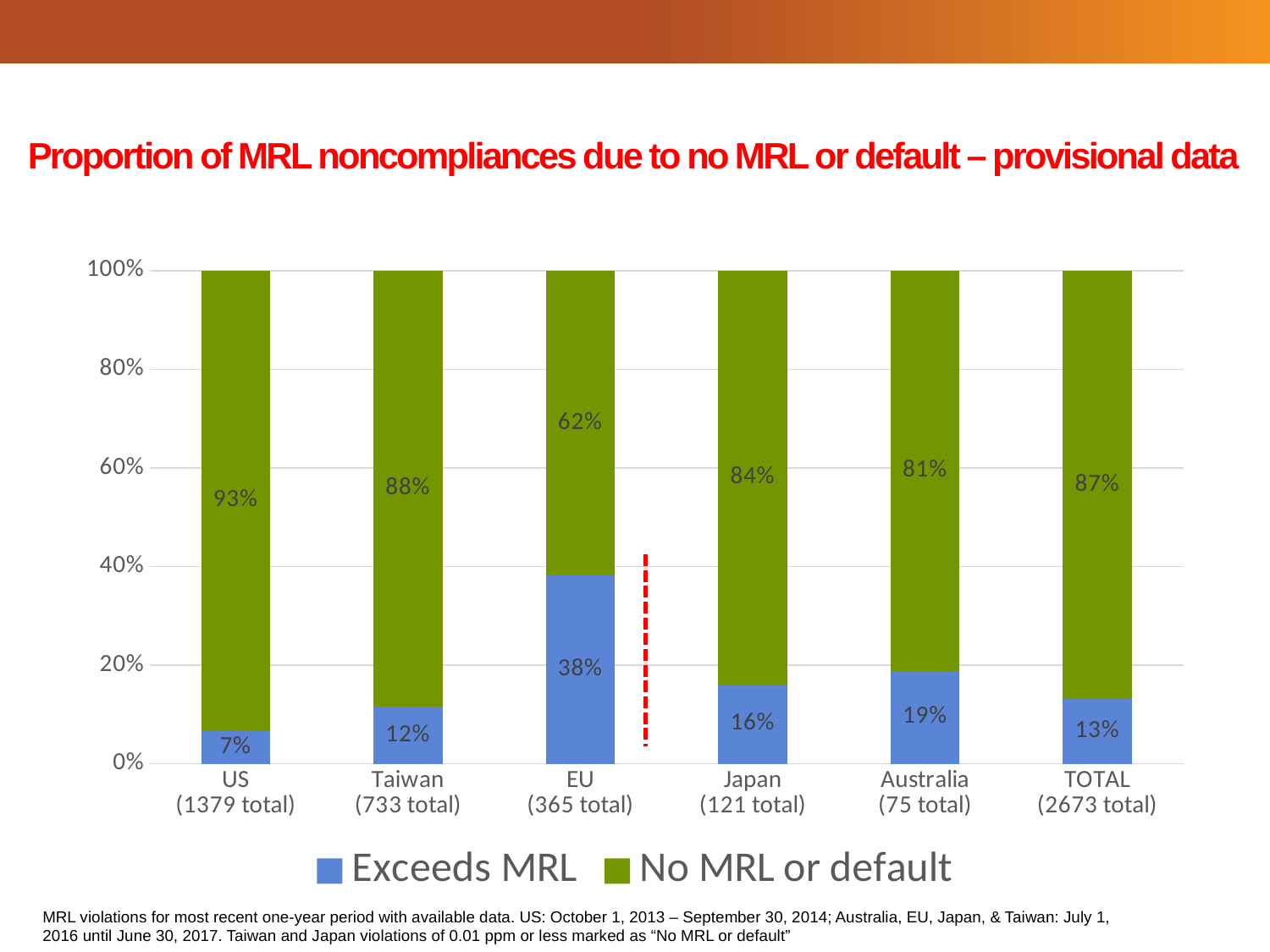
How many categories are shown on the x axis? 6 What is the 'No MRL or default' value for the US? 93% Which series is shown in green? No MRL or default Which is larger, the 'Exceeds MRL' value for Japan or for Australia? Australia What is the difference between the 'No MRL or default' values for Taiwan and Japan? 4% What kind of chart is shown on the slide? Stacked bar chart Which category has the highest 'Exceeds MRL' value? EU Which category has the lowest 'Exceeds MRL' value? US What is the 'Exceeds MRL' value for Australia? 19% How many series does the legend list? 2 What is the 'No MRL or default' value for TOTAL? 87% What is the 'Exceeds MRL' value for the EU? 38%